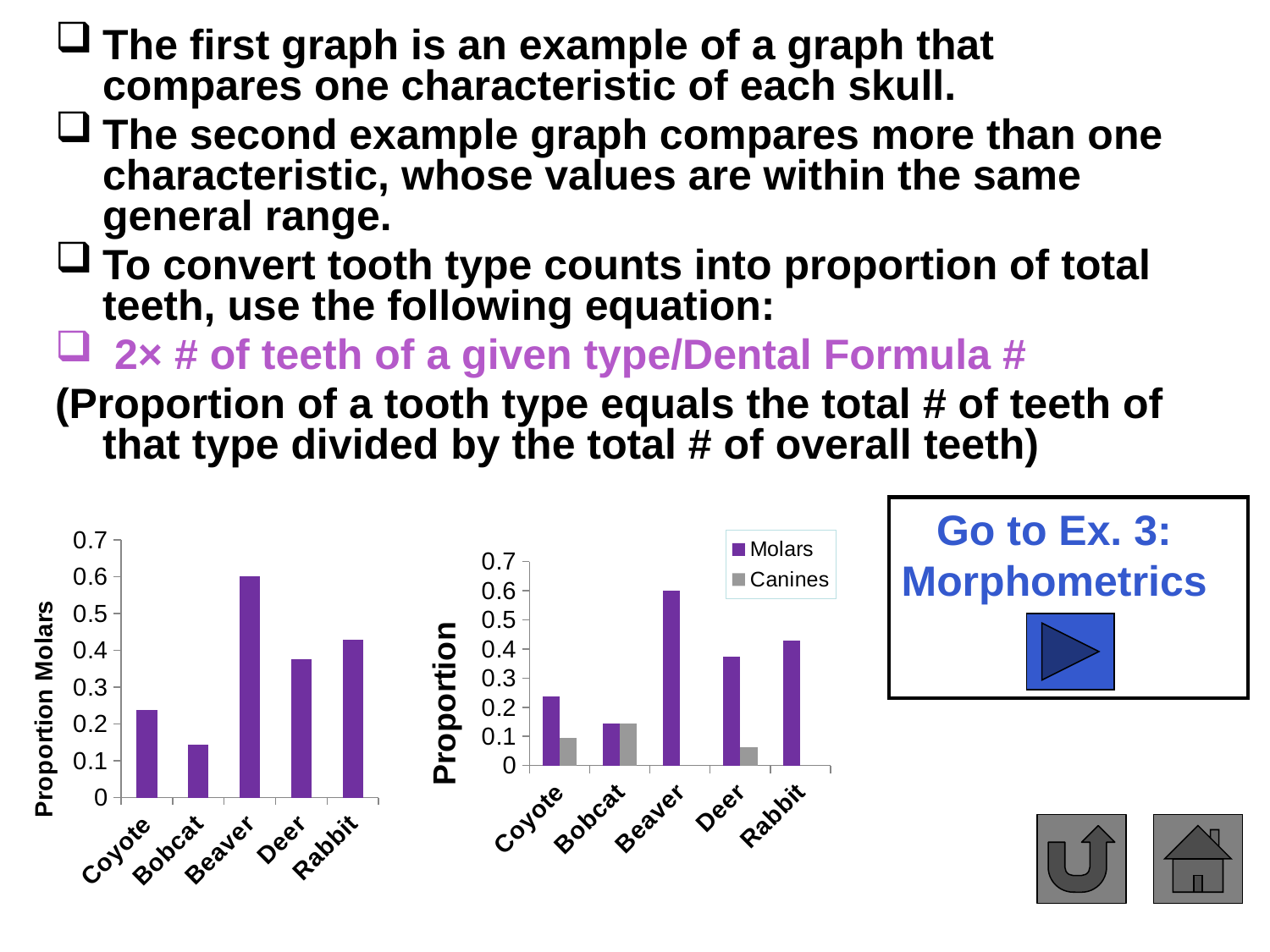
In the left chart (Proportion Molars), which animal has the highest proportion of molars? Beaver In the left chart (Proportion Molars), is the value for Rabbit greater or less than 0.4? greater In the right chart (Proportion), which is larger for Coyote: Molars or Canines? Molars What type of chart is the left chart (Proportion Molars)? bar chart In the right chart (Proportion), which animal has the highest Canines proportion? Bobcat In the right chart (Proportion), is the Molars value for Deer greater or less than 0.3? greater In the left chart (Proportion Molars), how many animals are shown on the x axis? 5 In the left chart (Proportion Molars), which animal has the lowest proportion of molars? Bobcat In the right chart (Proportion), how many series does the legend list? 2 In the left chart (Proportion Molars), is the value for Coyote greater or less than 0.3? less In the left chart (Proportion Molars), what is the proportion of molars for Beaver? 0.6 In the right chart (Proportion), what colour are the Canines bars? grey